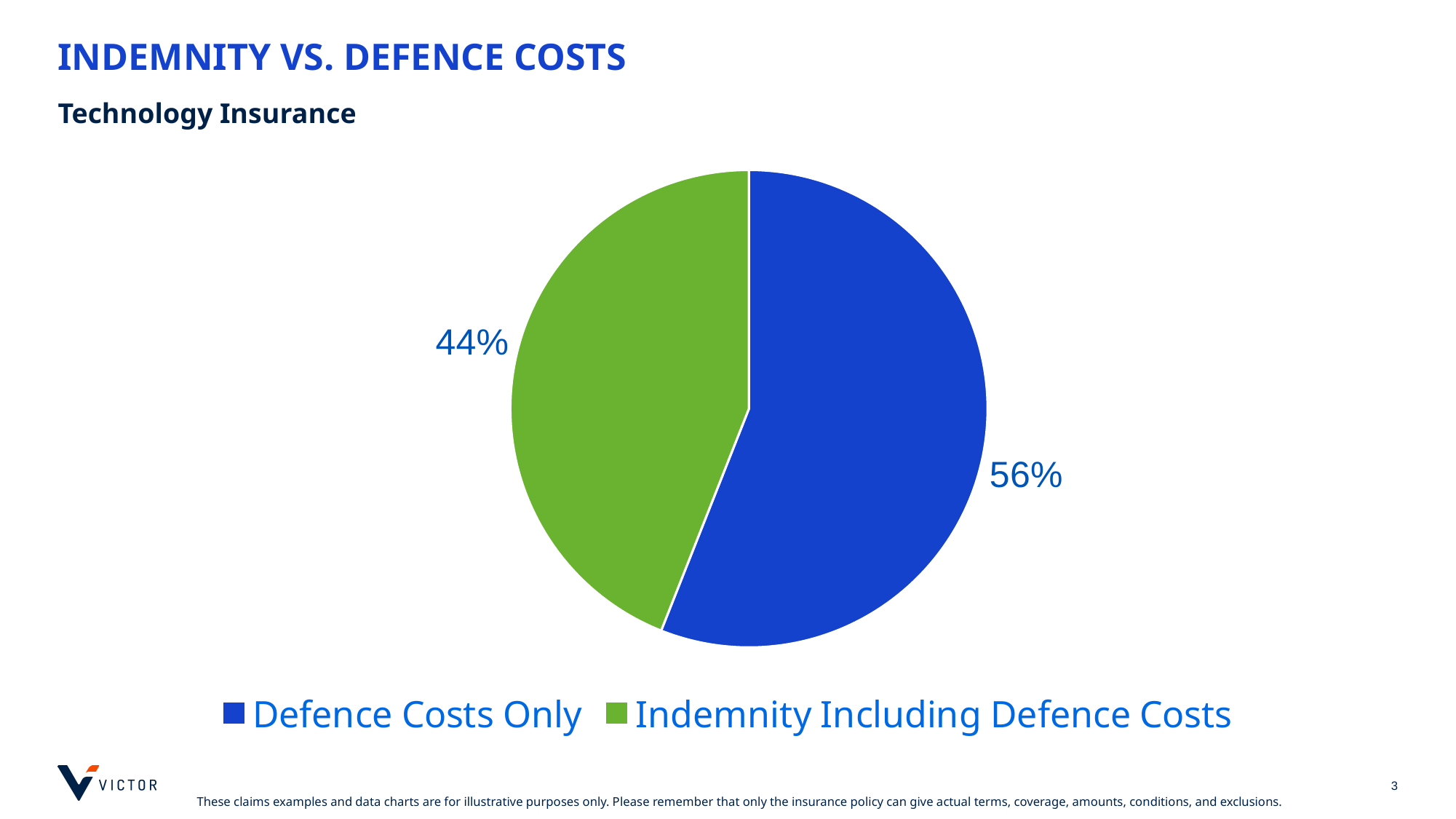
How many slices does the pie chart have? 2 What percentage of the pie is Indemnity Including Defence Costs? 44% What colour is the Defence Costs Only slice? Blue Which category has the largest share of the pie? Defence Costs Only What share of the pie does the green slice represent? 44% Which is larger: Defence Costs Only or Indemnity Including Defence Costs? Defence Costs Only What percentage of the pie is Defence Costs Only? 56% What is the title of the slide containing the chart? INDEMNITY VS. DEFENCE COSTS What kind of chart is shown on the slide? Pie chart Which category has the smallest share of the pie? Indemnity Including Defence Costs How many entries does the legend list? 2 What is the difference in percentage points between Defence Costs Only and Indemnity Including Defence Costs? 12